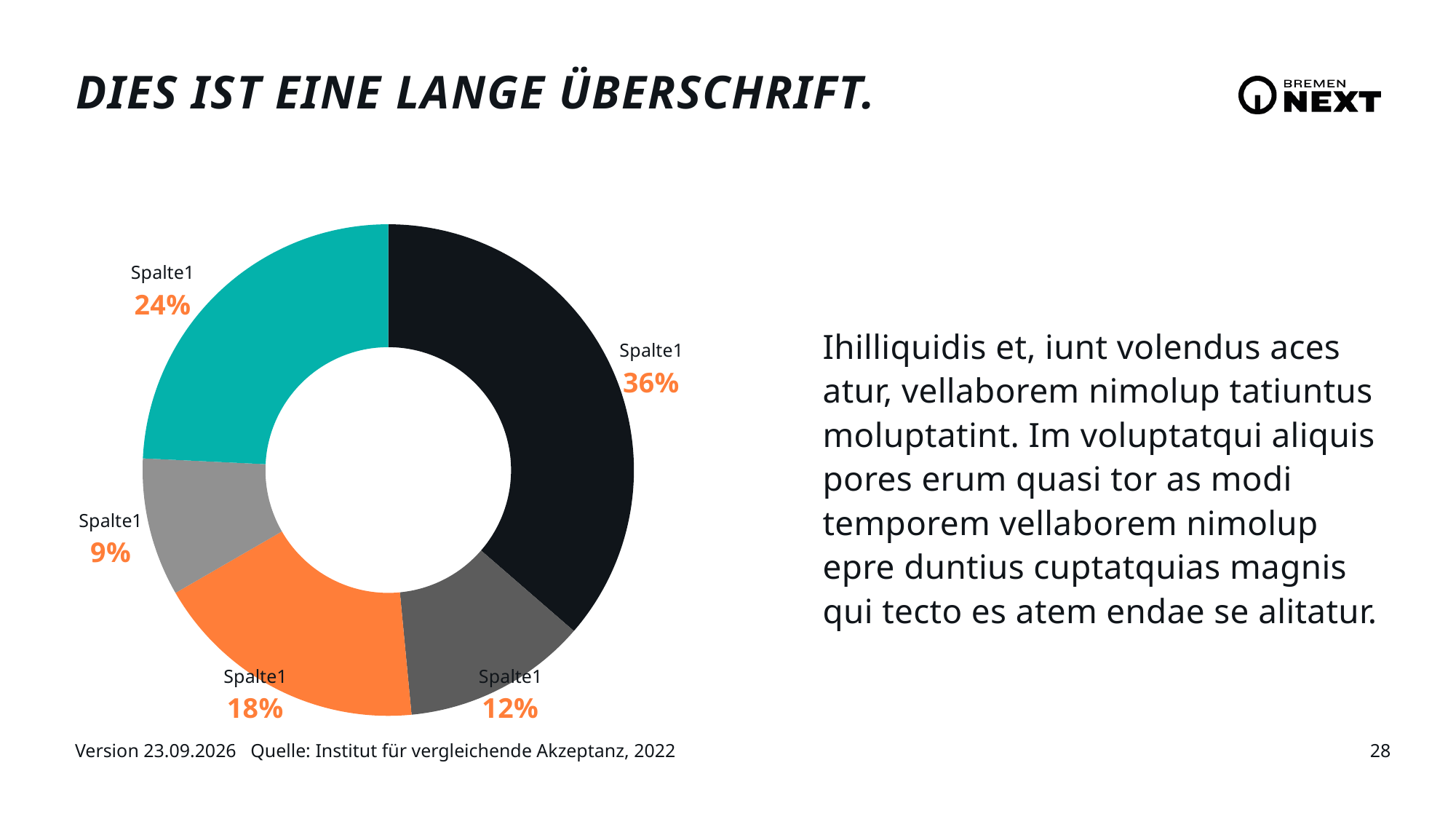
How many slices does the donut chart have? 5 What is the difference in percentage points between the black slice (36%) and the teal slice (24%)? 12 percentage points What label is shown for every slice of the donut chart? Spalte1 Which slice is larger, the teal slice or the orange slice? The teal slice What percentage is shown for the black slice of the donut chart? 36% What kind of chart is shown on the slide? Donut (pie) chart What colour is the largest slice of the donut chart? Black What percentage is shown for the orange slice of the donut chart? 18% What is the largest percentage shown on the donut chart? 36% What percentage is shown for the teal slice of the donut chart? 24% What is the difference in percentage points between the orange slice (18%) and the dark grey slice (12%)? 6 percentage points What is the smallest percentage shown on the donut chart? 9%